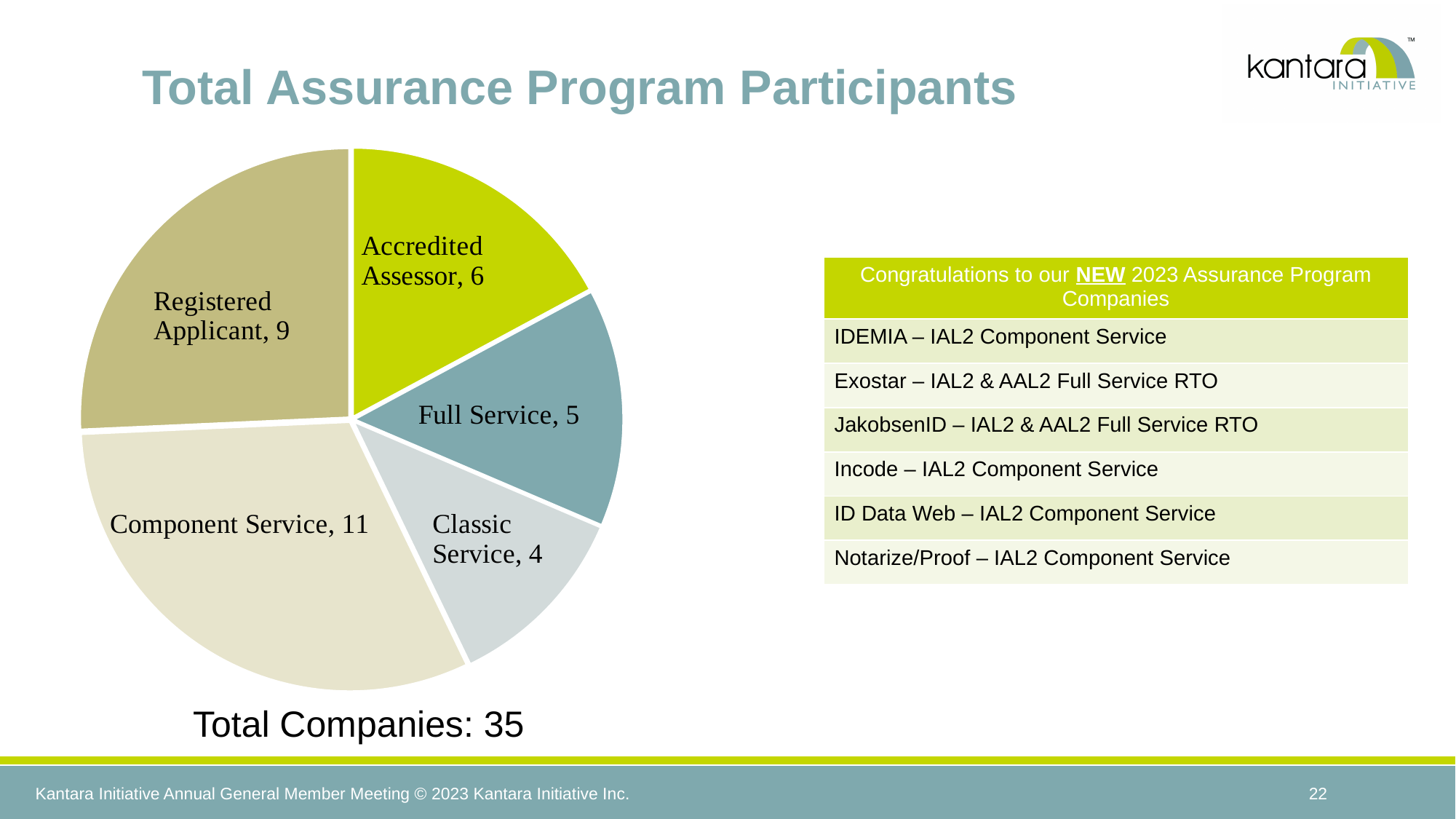
Which is larger, Registered Applicant or Accredited Assessor? Registered Applicant What kind of chart is shown on the slide? pie chart What is the value for Classic Service? 4 What is the difference between Component Service and Full Service? 6 Which category has the smallest slice? Classic Service What is the total number of companies shown below the pie chart? 35 What is the value for Registered Applicant? 9 What is the title of the chart? Total Assurance Program Participants What is the value for Accredited Assessor? 6 Which category has the largest slice? Component Service What is the value for Component Service? 11 How many slices does the pie chart have? 5